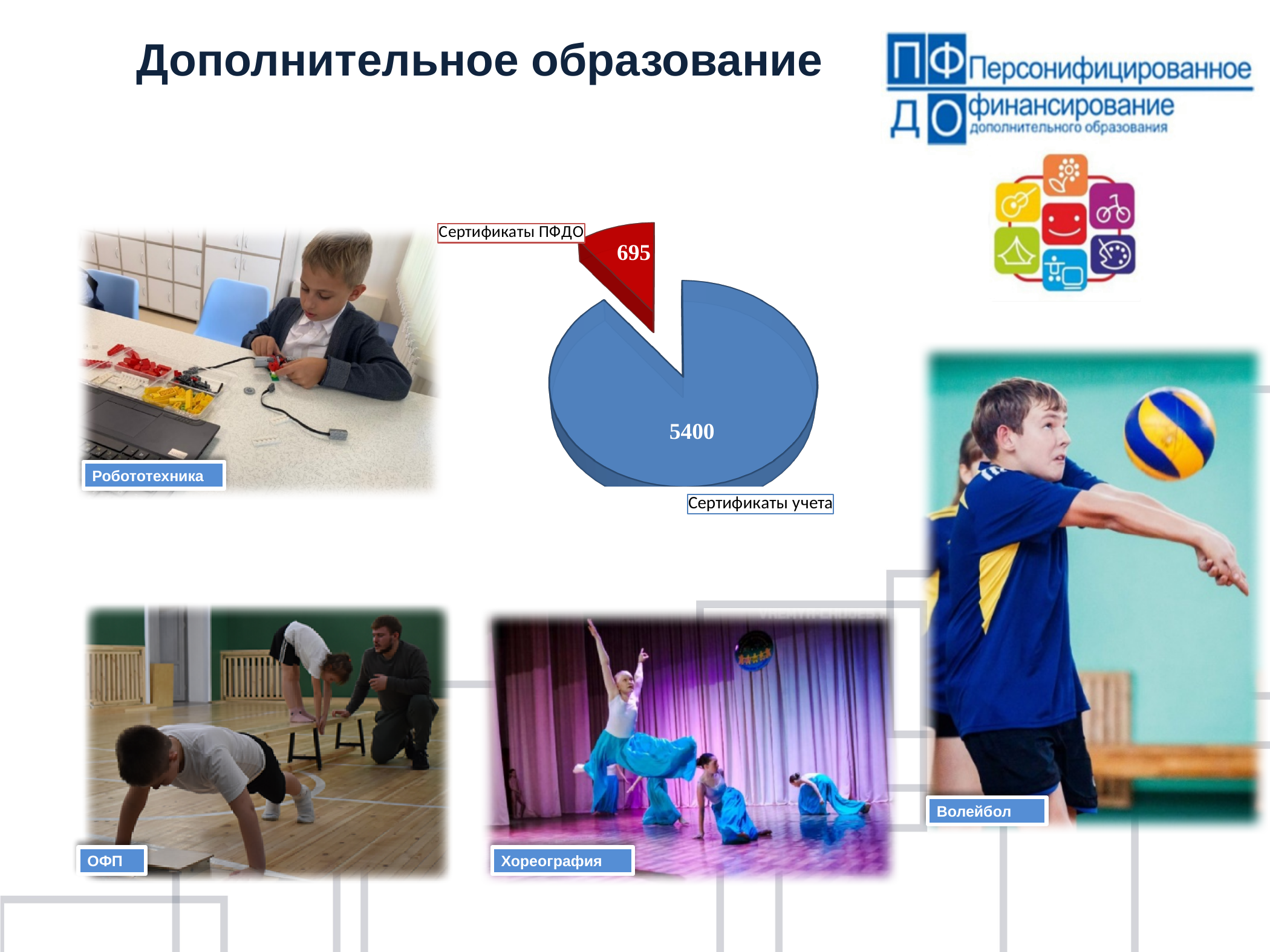
What value is shown for Сертификаты ПФДО in the pie chart? 695 What is the difference between the values for Сертификаты учета and Сертификаты ПФДО? 4705 Which slice of the pie chart is the smallest? Сертификаты ПФДО Which slice of the pie chart is the largest? Сертификаты учета Which is larger: Сертификаты ПФДО or Сертификаты учета? Сертификаты учета What value is shown for Сертификаты учета in the pie chart? 5400 How many slices does the pie chart have? 2 What colour is the Сертификаты ПФДО slice in the pie chart? Red What kind of chart is shown on the slide? Pie chart What is the total of the two values shown in the pie chart? 6095 What colour is the Сертификаты учета slice in the pie chart? Blue